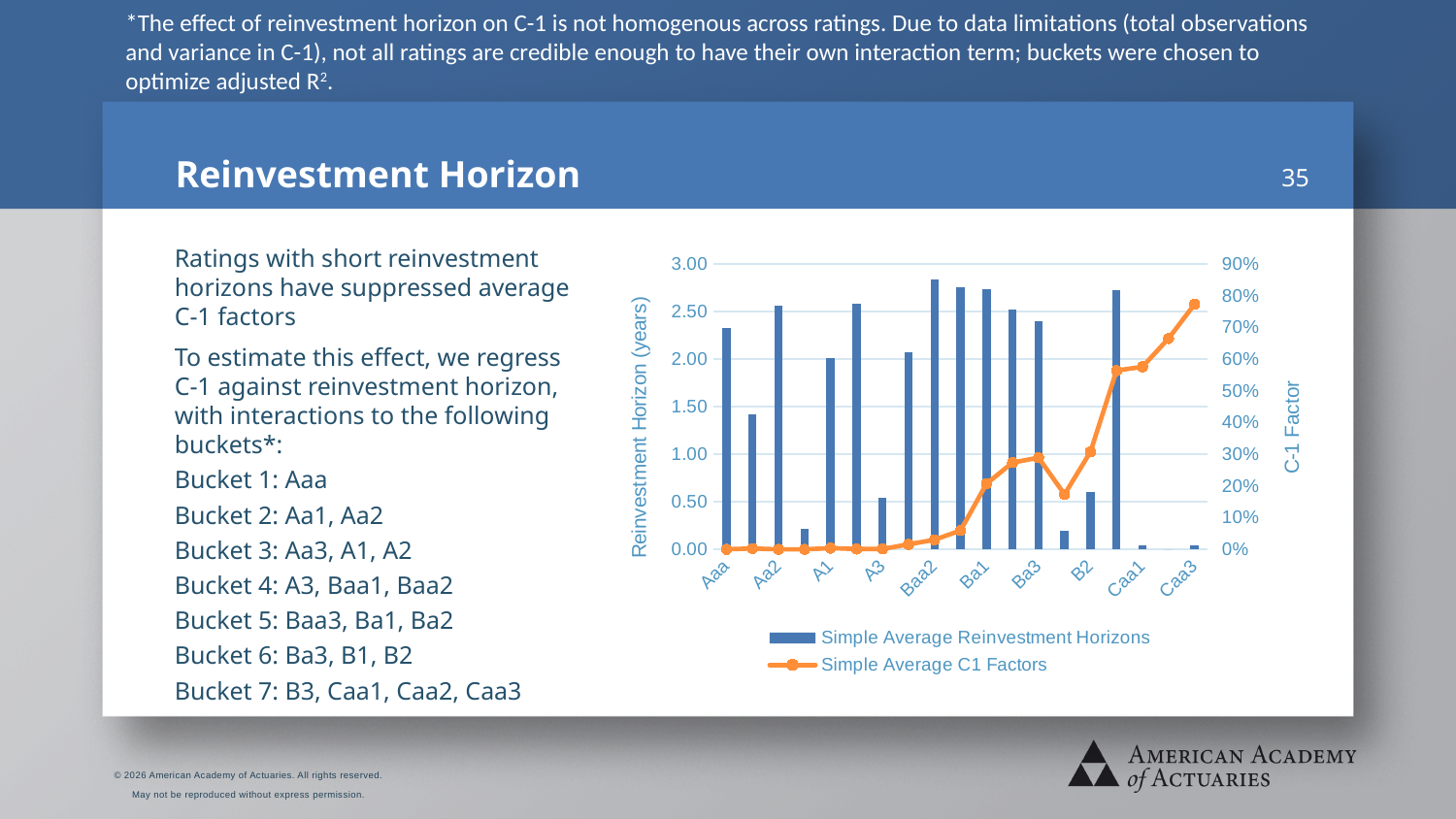
Is the Simple Average Reinvestment Horizon bar for Baa2 greater or less than 2.50? greater What kind of chart is shown on the slide? A combined bar and line chart Is the Simple Average C1 Factor for Aaa greater or less than 10%? less Is the Simple Average Reinvestment Horizon bar for A3 greater or less than 1.00? less What is the label of the left vertical axis of the chart? Reinvestment Horizon (years) Does the Simple Average C1 Factors line generally rise or fall moving from Aaa to Caa3 along the x axis? rise How many series does the chart legend list? 2 Which has the larger Simple Average C1 Factor, Ba1 or Caa3? Caa3 What are the two series named in the chart legend? Simple Average Reinvestment Horizons; Simple Average C1 Factors Which has the larger Simple Average Reinvestment Horizon bar, Aaa or A3? Aaa